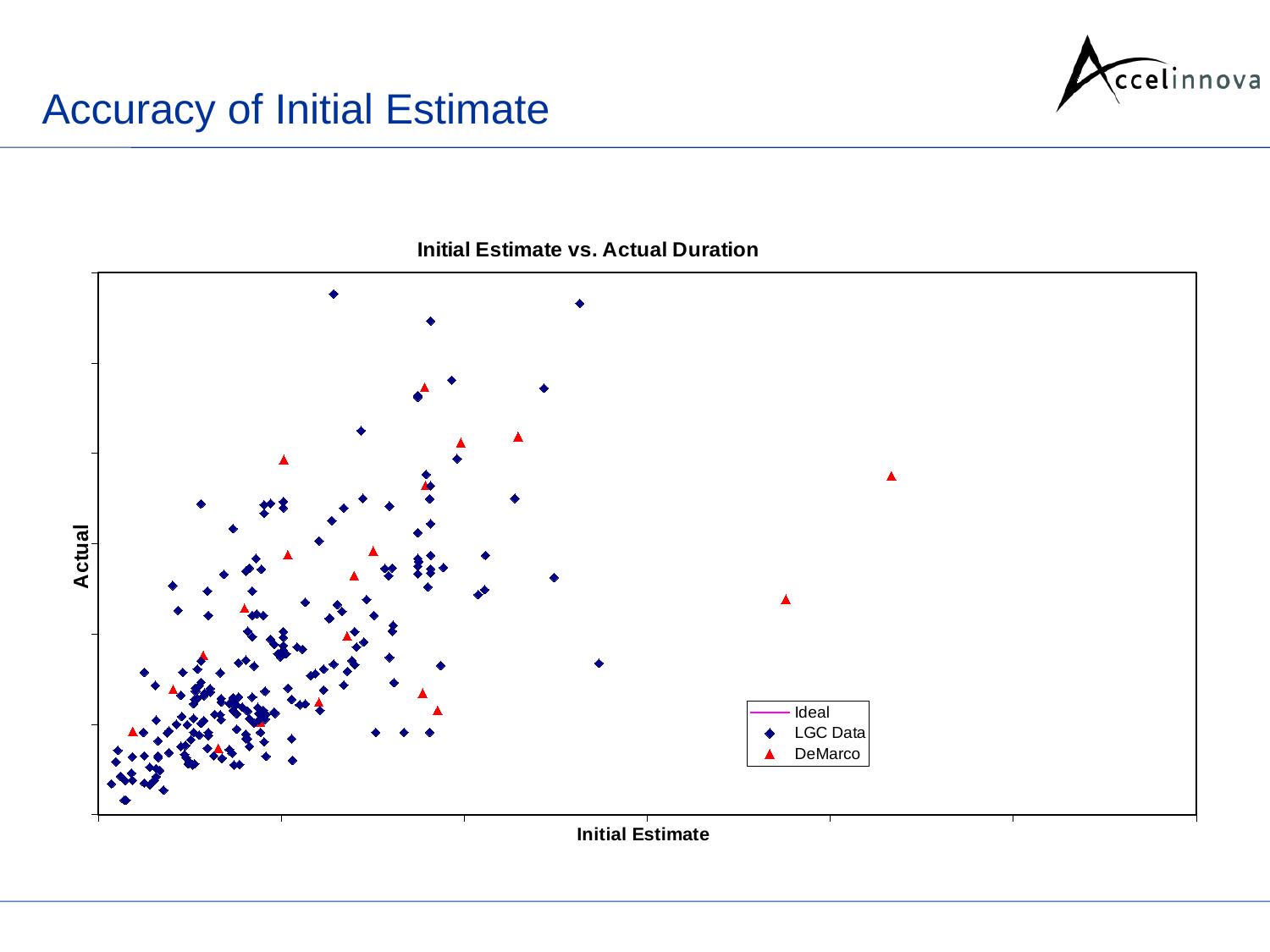
Which series is plotted with red triangles? DeMarco What is the title of the chart? Initial Estimate vs. Actual Duration Do the Actual values generally rise or fall as the Initial Estimate increases along the x axis? Rise What kind of chart is shown on the slide? Scatter chart How many series does the legend of the chart list? 3